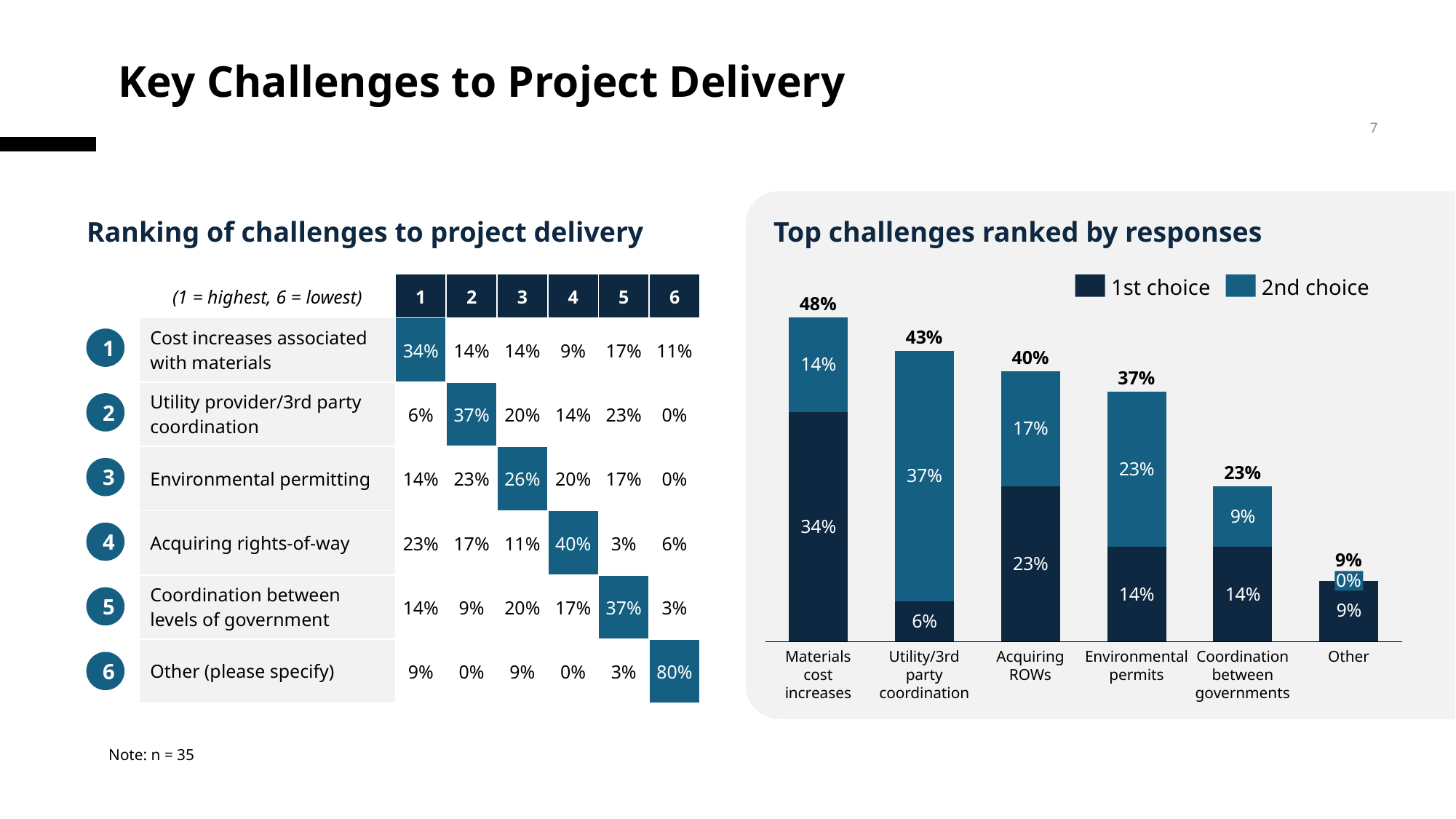
How many categories are shown on the x axis of the 'Top challenges ranked by responses' chart? 6 In the 'Top challenges ranked by responses' chart, what is the 2nd choice value for Environmental permits? 23% Do the bar totals in the 'Top challenges ranked by responses' chart rise or fall from left to right? Fall How many series does the legend of the 'Top challenges ranked by responses' chart list? 2 In the 'Top challenges ranked by responses' chart, what is the total for the Acquiring ROWs bar? 40% In the 'Top challenges ranked by responses' chart, which is larger: the 2nd choice value for Acquiring ROWs or the 2nd choice value for Coordination between governments? Acquiring ROWs What kind of chart is 'Top challenges ranked by responses'? Stacked bar chart In the 'Top challenges ranked by responses' chart, what is the difference between the 1st choice values for Materials cost increases and Acquiring ROWs? 11% In the 'Top challenges ranked by responses' chart, what is the 1st choice value for Materials cost increases? 34% In the 'Top challenges ranked by responses' chart, what is the 2nd choice value for Utility/3rd party coordination? 37% In the 'Top challenges ranked by responses' chart, which category has the highest total? Materials cost increases In the 'Top challenges ranked by responses' chart, which category has the lowest total? Other